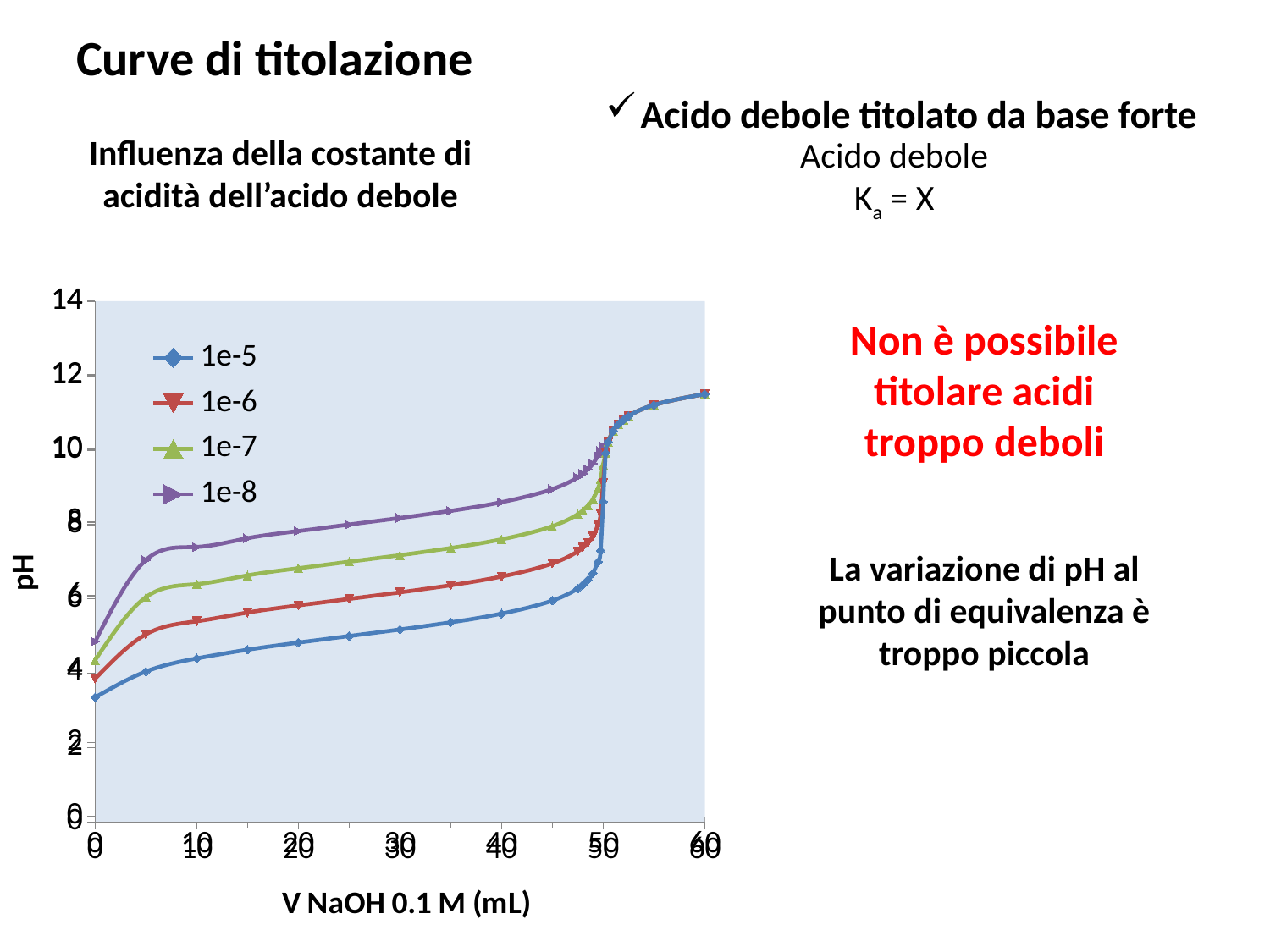
Is the pH of the 1e-8 series at 40 mL greater or less than 8? greater Is the pH of the 1e-5 series at 0 mL greater or less than 4? less At 20 mL of NaOH, which series has the higher pH, 1e-8 or 1e-5? 1e-8 What are the series names listed in the chart legend? 1e-5, 1e-6, 1e-7, 1e-8 What is the title of the x axis of the chart? V NaOH 0.1 M (mL) What kind of chart is shown on the slide? line chart Is the pH of the 1e-5 series at 60 mL greater or less than 10? greater Does the pH of the 1e-7 series rise or fall as the volume of NaOH increases? rise How many series does the chart legend list? 4 Which series has the lowest pH at 0 mL of NaOH? 1e-5 Which series has the highest pH at 0 mL of NaOH? 1e-8